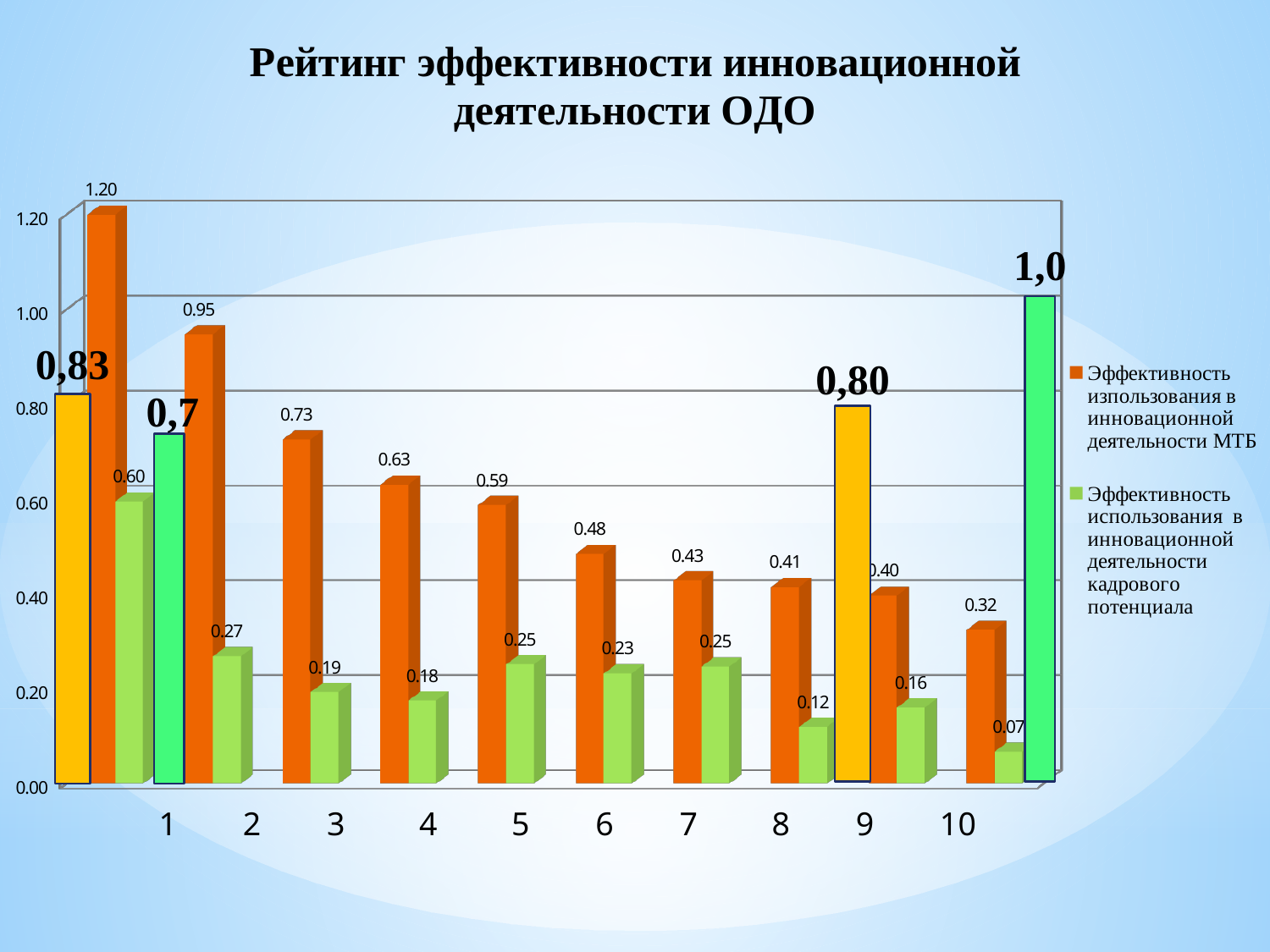
Which category has the lowest value in the green series (кадрового потенциала)? 10 Which category has the highest value in the orange series (МТБ)? 1 What is the value of the orange series (Эффективность использования в инновационной деятельности МТБ) for category 1? 1.20 Which is larger: the green series value for category 5 or for category 6? category 5 What is the value of the orange series (МТБ) for category 7? 0.43 What is the value of the green series (кадрового потенциала) for category 10? 0.07 How many categories are shown on the x axis? 10 How many series does the legend list? 2 What kind of chart is shown on the slide? bar chart What is the difference between the orange (МТБ) and green (кадрового потенциала) values for category 2? 0.68 What is the value of the green series (кадрового потенциала) for category 4? 0.18 Do the values of the orange series (МТБ) rise or fall from category 1 to category 10? fall